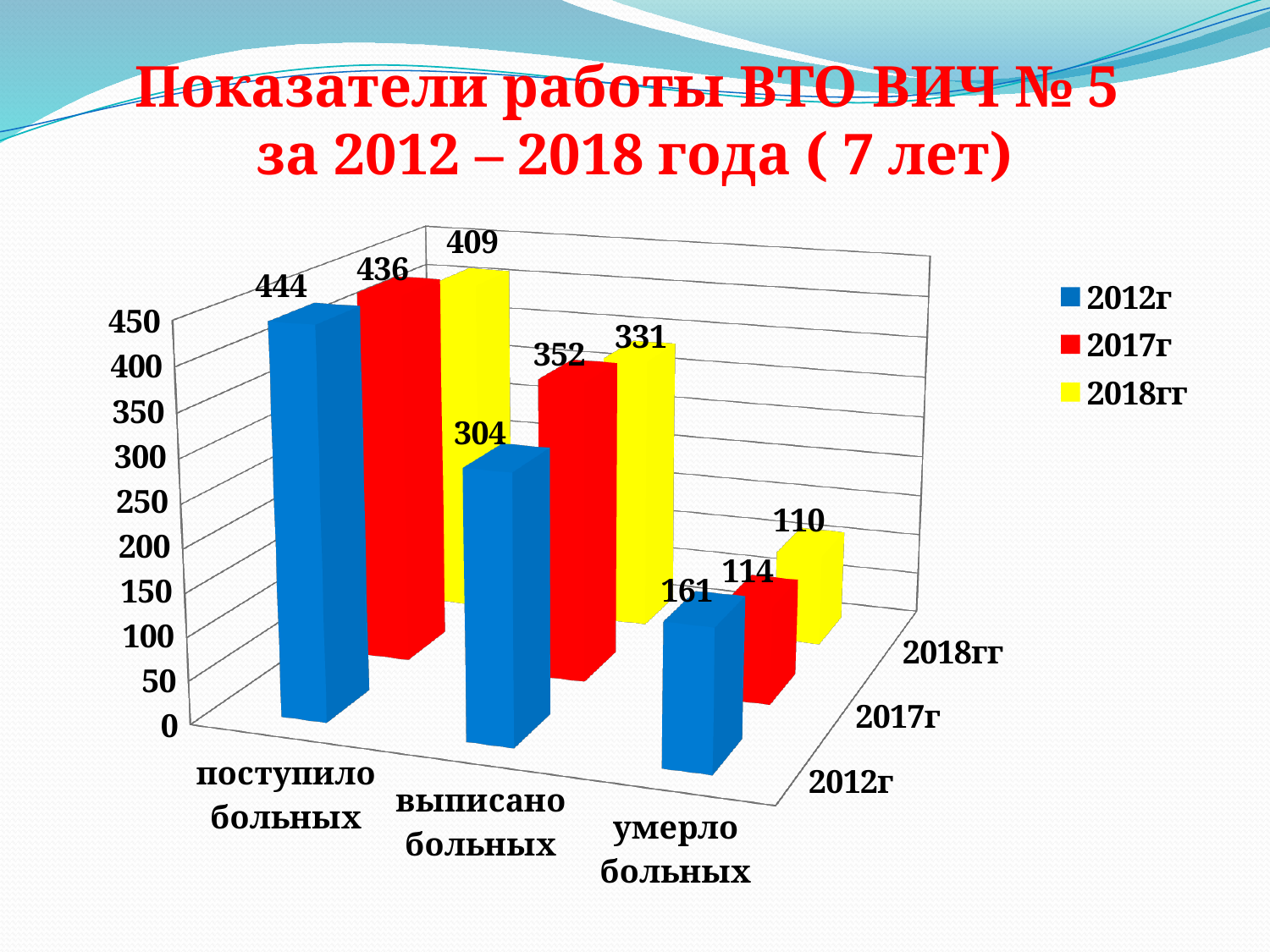
Which category has the lowest value in the 2017г series? умерло больных What is the value for 'выписано больных' in the 2017г series? 352 How many categories are shown on the x axis? 3 Which category has the highest value in the 2018гг series? поступило больных What is the value for 'умерло больных' in the 2018гг series? 110 What is the value for 'выписано больных' in the 2012г series? 304 Which is larger for 'выписано больных': the 2012г value or the 2018гг value? 2018гг What kind of chart is shown on the slide? bar chart What is the value for 'поступило больных' in the 2012г series? 444 What is the difference between the 2012г and 2017г values for 'умерло больных'? 47 What colour represents the 2017г series? red How many series does the legend list? 3